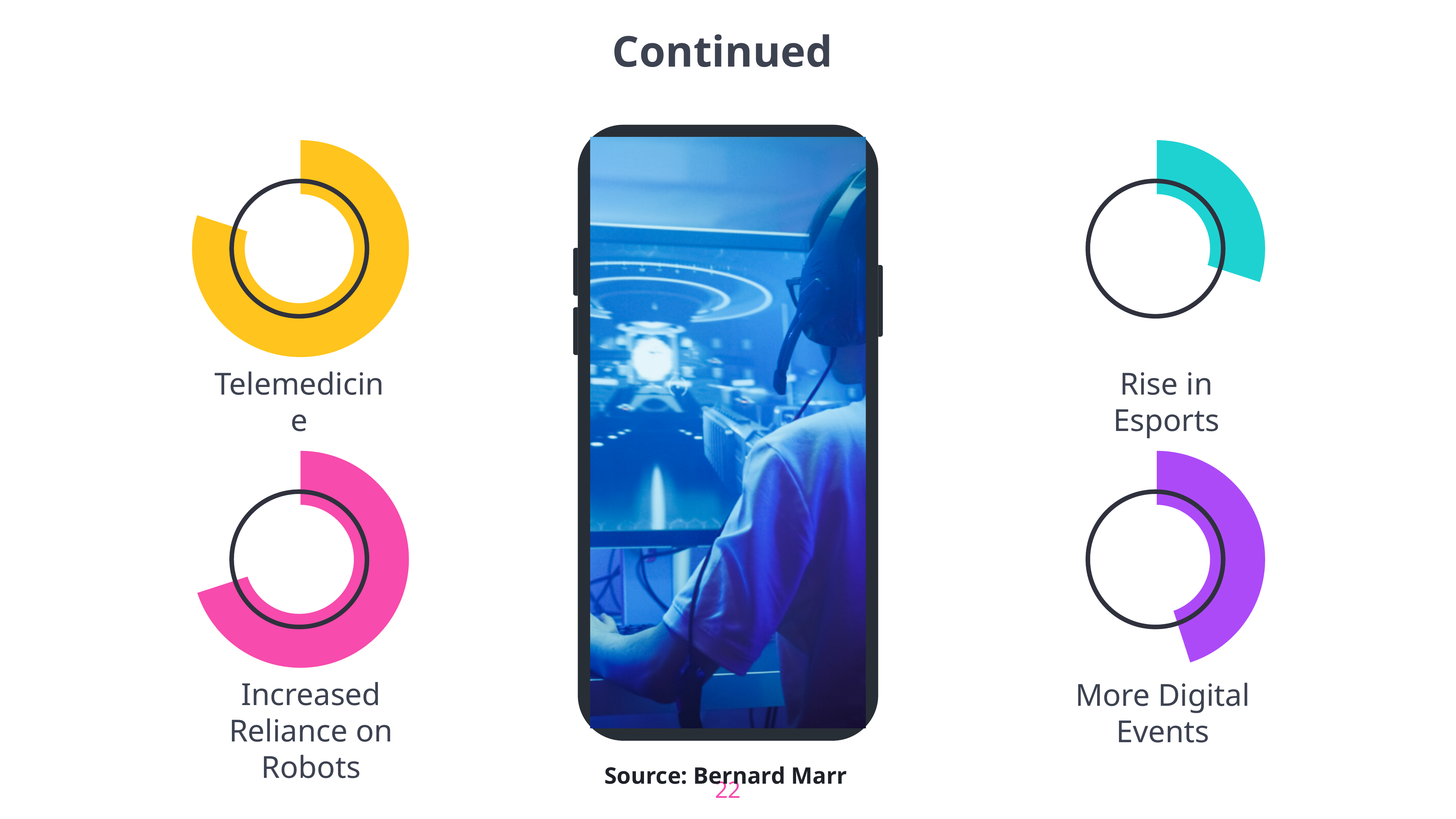
Which has the larger filled arc, the Rise in Esports ring or the More Digital Events ring? More Digital Events Which has the larger filled arc, the Telemedicine ring or the Rise in Esports ring? Telemedicine What colour is the ring graphic labelled Telemedicine? Yellow How many ring (donut) graphics are shown on the slide? 4 What colour is the ring graphic labelled More Digital Events? Purple Which labelled ring graphic has the smallest filled arc? Rise in Esports